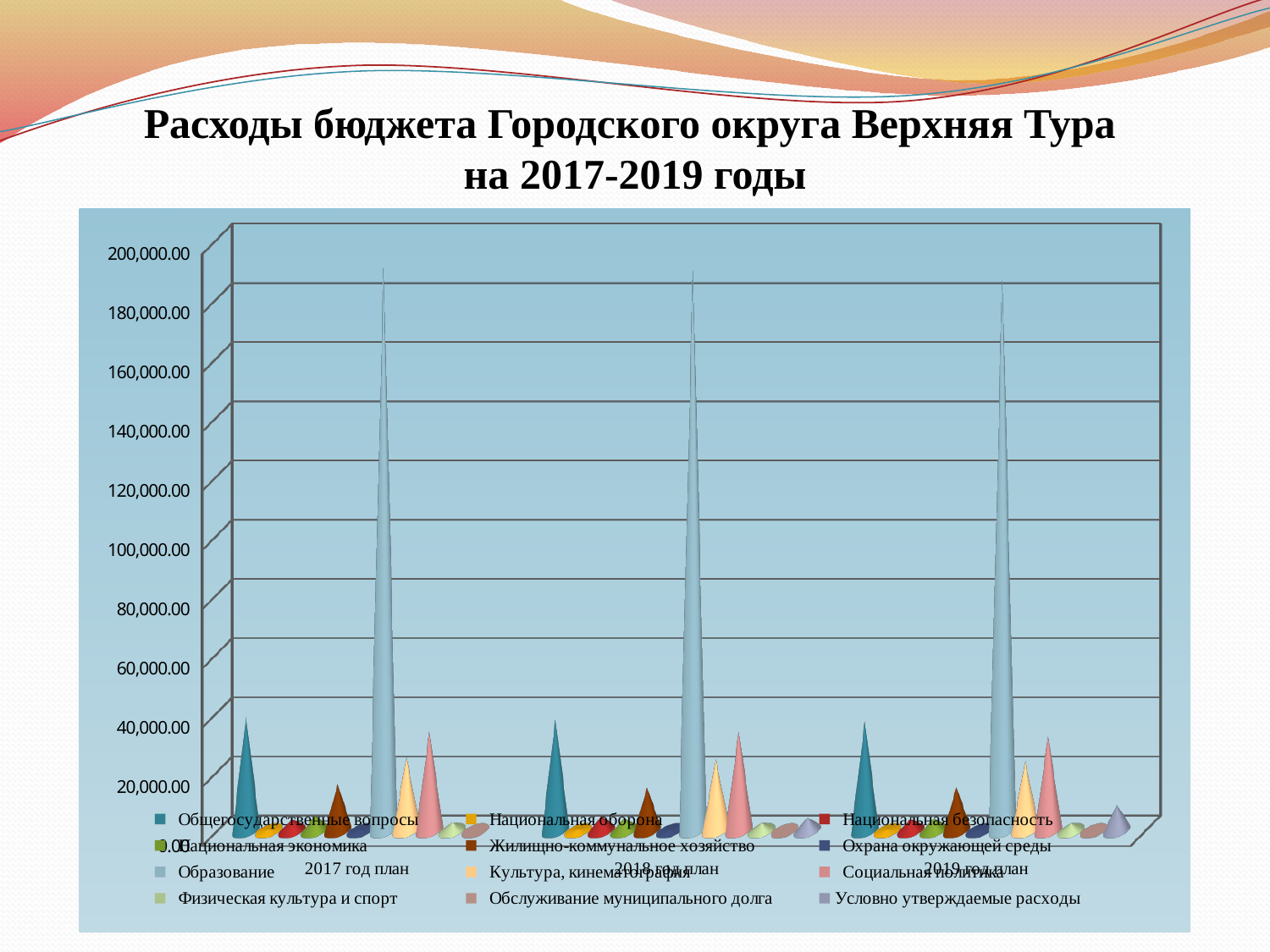
Is the value for Общегосударственные вопросы in 2017 год план greater or less than 60,000.00? less In 2018 год план, which is larger: Образование or Общегосударственные вопросы? Образование Which series has the highest value in 2017 год план? Образование How many series does the chart legend list? 12 Which series has the highest value in 2019 год план? Образование What kind of chart is shown on the slide? bar chart Is the value for Образование in 2017 год план greater or less than 180,000.00? greater Is the value for Общегосударственные вопросы in 2018 год план greater or less than 20,000.00? greater How many categories (years) are shown on the x axis of the chart? 3 What is the title of the slide above the chart? Расходы бюджета Городского округа Верхняя Тура на 2017-2019 годы In 2017 год план, which is larger: Общегосударственные вопросы or Культура, кинематография? Общегосударственные вопросы